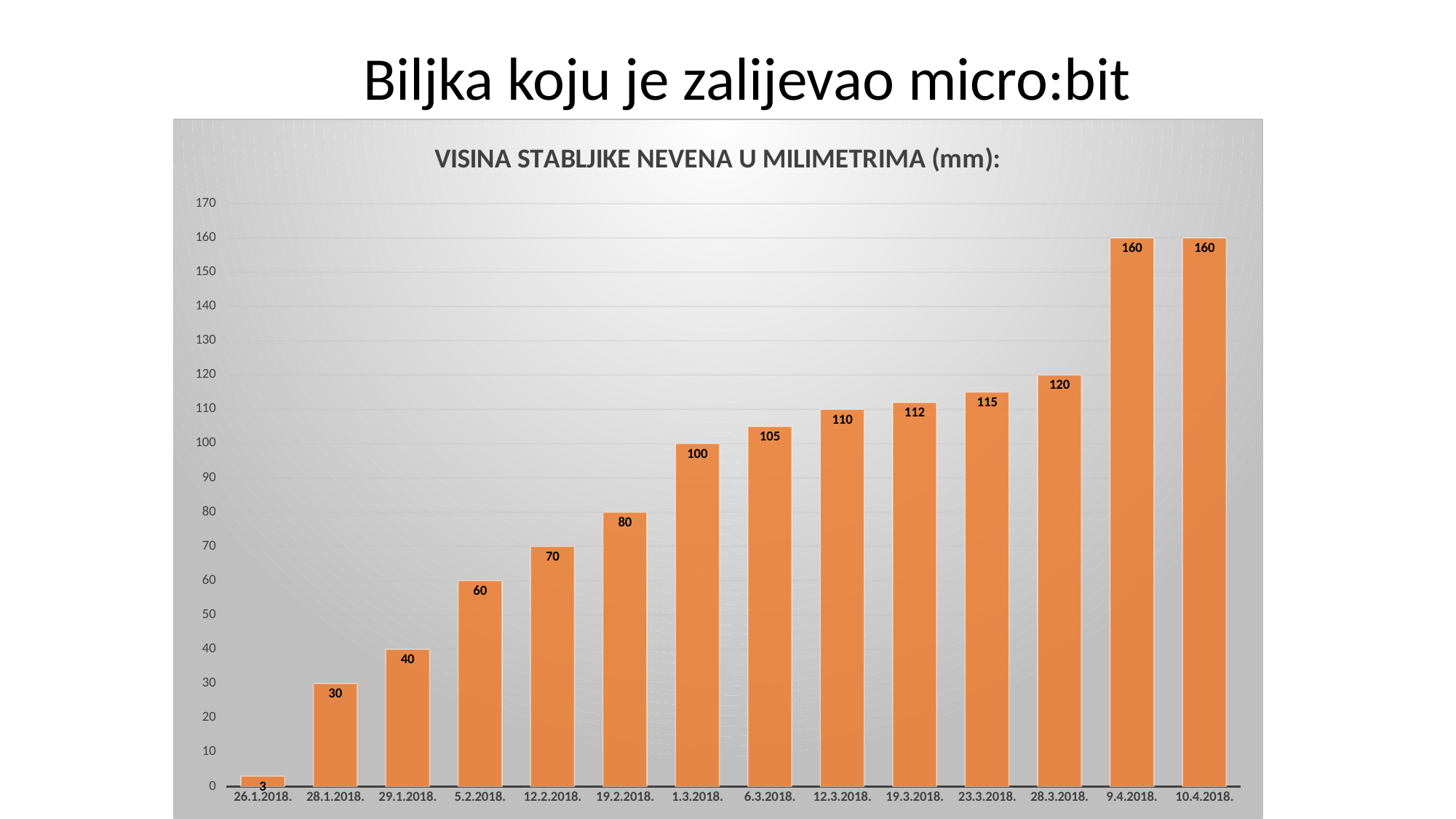
Do the values rise or fall from left to right along the x axis? rise Which date has the lowest value? 26.1.2018. Which is larger, the value for 12.2.2018. or the value for 1.3.2018.? 1.3.2018. What is the value for 5.2.2018.? 60 What is the value for 26.1.2018.? 3 What kind of chart is this? bar chart What is the difference between the values for 9.4.2018. and 28.3.2018.? 40 What is the highest value shown on the chart? 160 How many dates are shown on the x axis? 14 What is the value for 19.3.2018.? 112 What is the title of the chart? VISINA STABLJIKE NEVENA U MILIMETRIMA (mm): What is the difference between the values for 28.3.2018. and 23.3.2018.? 5